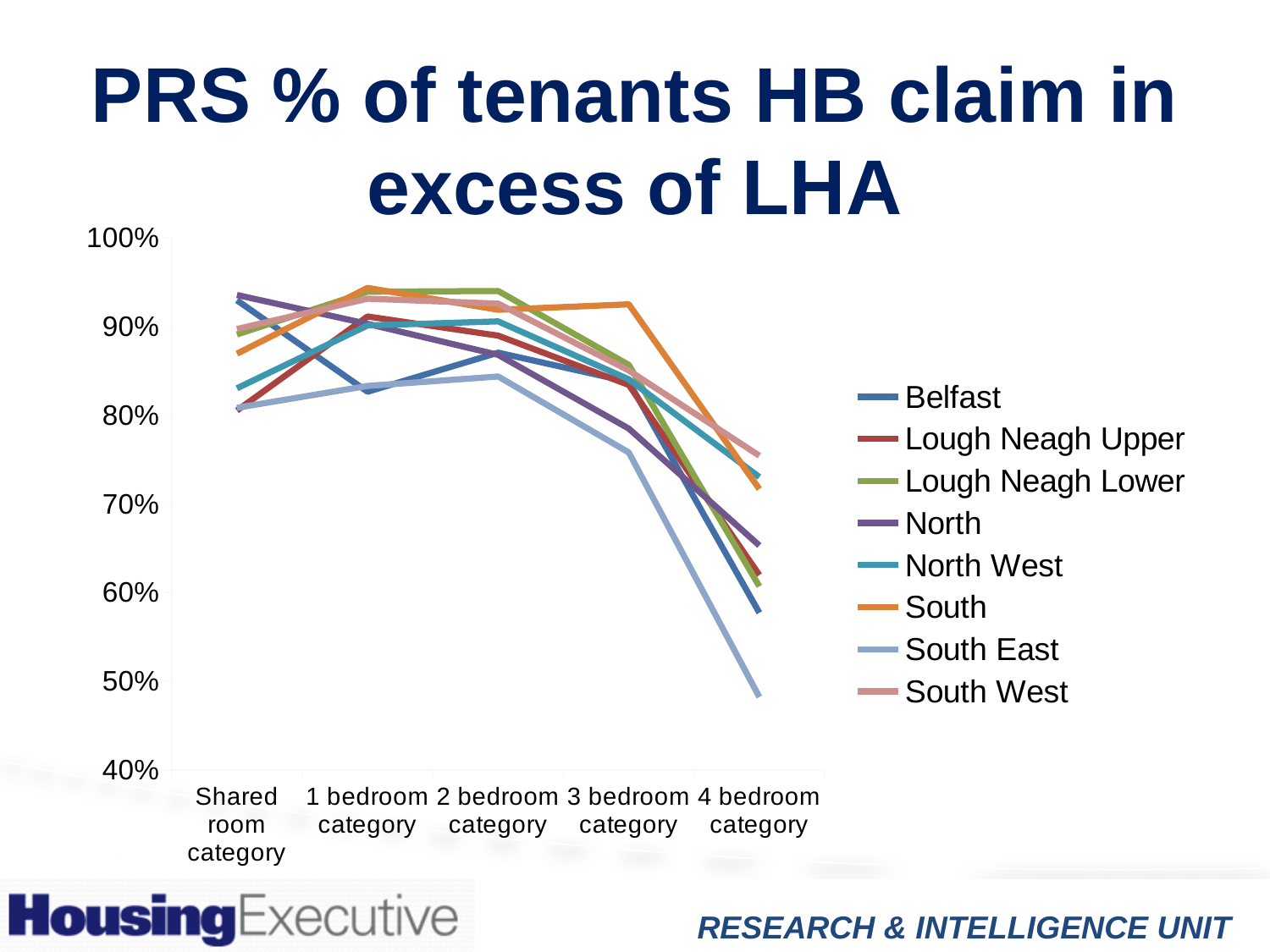
How many series does the legend list? 8 Do the values for all series rise or fall from the 3 bedroom category to the 4 bedroom category? fall Which series is lowest in the 4 bedroom category? South East Is the value for South West in the 4 bedroom category greater or less than 70%? greater How many bedroom categories are shown along the x axis? 5 What kind of chart is shown on the slide? Line chart Is the value for Belfast in the 4 bedroom category greater or less than 60%? less Is the value for South in the 3 bedroom category greater or less than 90%? greater What is the title of the chart? PRS % of tenants HB claim in excess of LHA In the 4 bedroom category, which is larger: South or South East? South Which series is highest in the 3 bedroom category? South